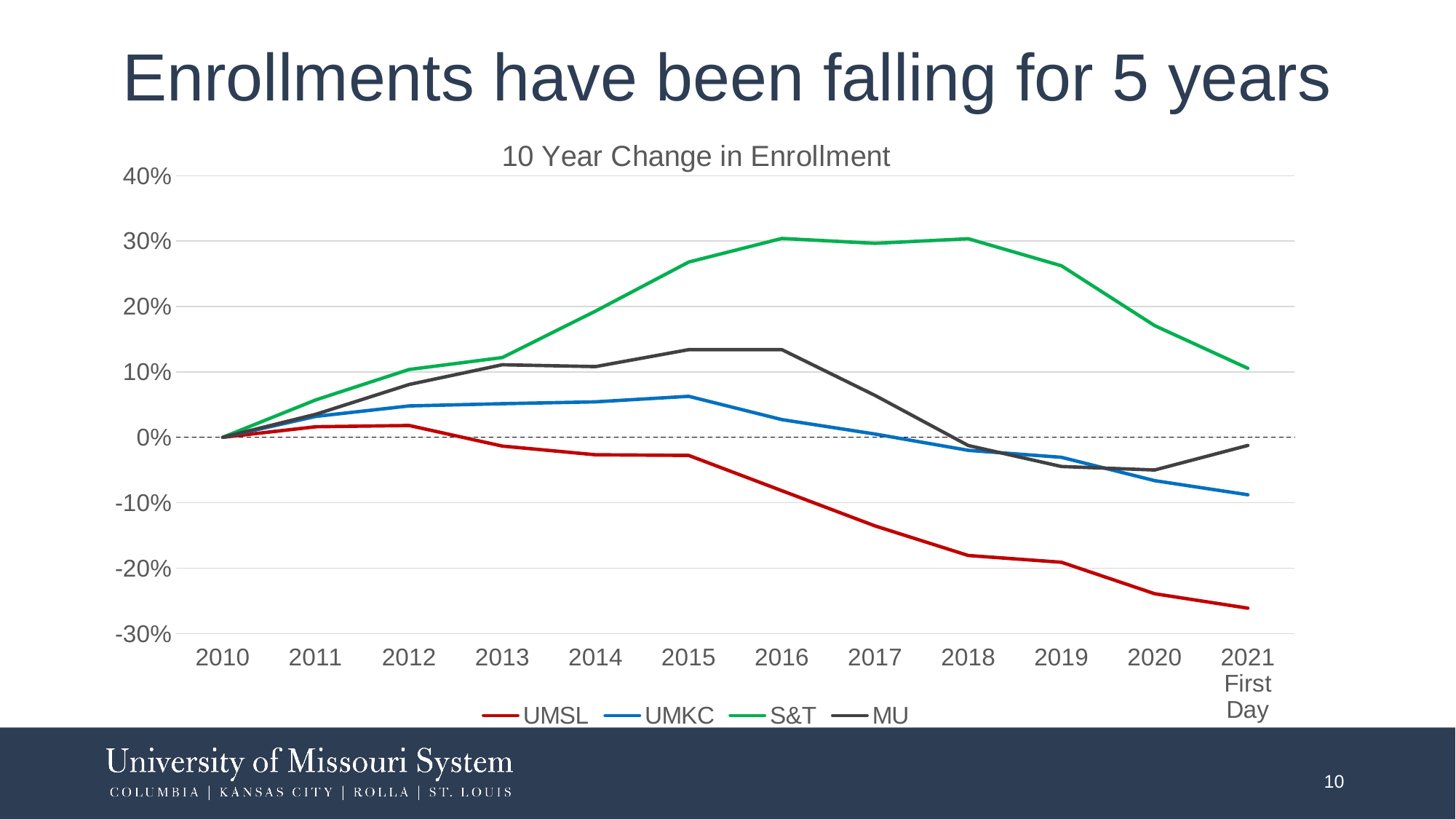
What is the title of the chart? 10 Year Change in Enrollment What kind of chart is shown on the slide? line chart Does the UMSL line rise or fall from 2012 to 2021 First Day? fall Is the value for UMSL in 2021 First Day greater or less than -20%? less Which series has the highest value in 2021 First Day? S&T Which series has the lowest value in 2021 First Day? UMSL Is the value for MU in 2015 greater or less than 10%? greater Is the value for S&T in 2016 greater or less than 20%? greater In 2014, which is larger, the value for MU or the value for UMKC? MU How many series does the legend list? 4 How many years are shown along the x axis? 12 What is the value for UMSL in 2010? 0%